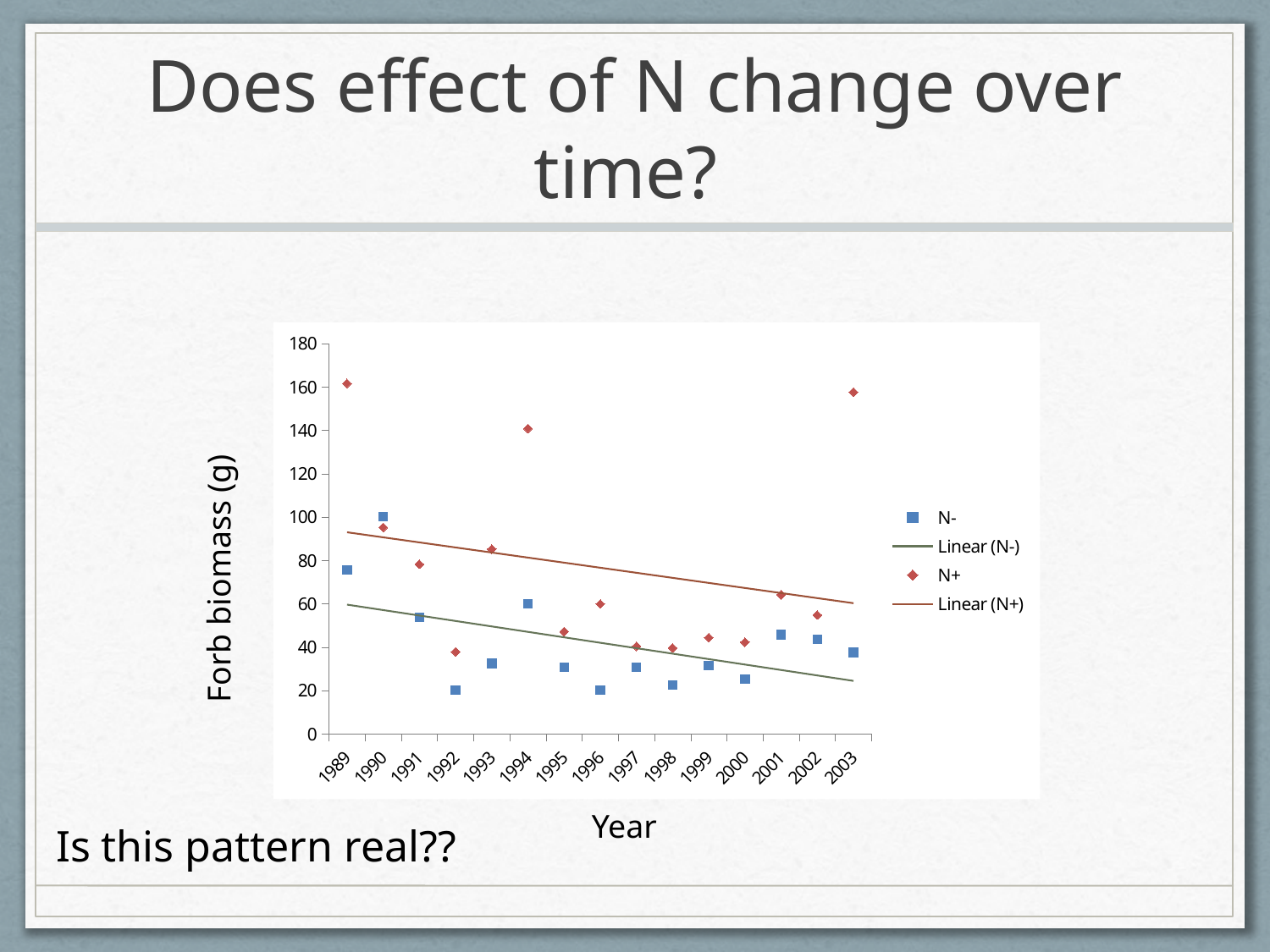
How many entries does the chart legend list? 4 What is the title of the x axis of the chart? Year Is the N- value for 1992 greater or less than 40? less In which year is the N- series at its highest? 1990 Does the Linear (N+) trendline rise or fall from 1989 to 2003? fall What kind of chart is shown on the slide? scatter chart Is the N- value for 1990 greater or less than 80? greater In 1994, which series has the larger value, N+ or N-? N+ Is the N+ value for 2003 greater or less than 140? greater What is the title of the y axis of the chart? Forb biomass (g) How many years are shown along the x axis of the chart? 15